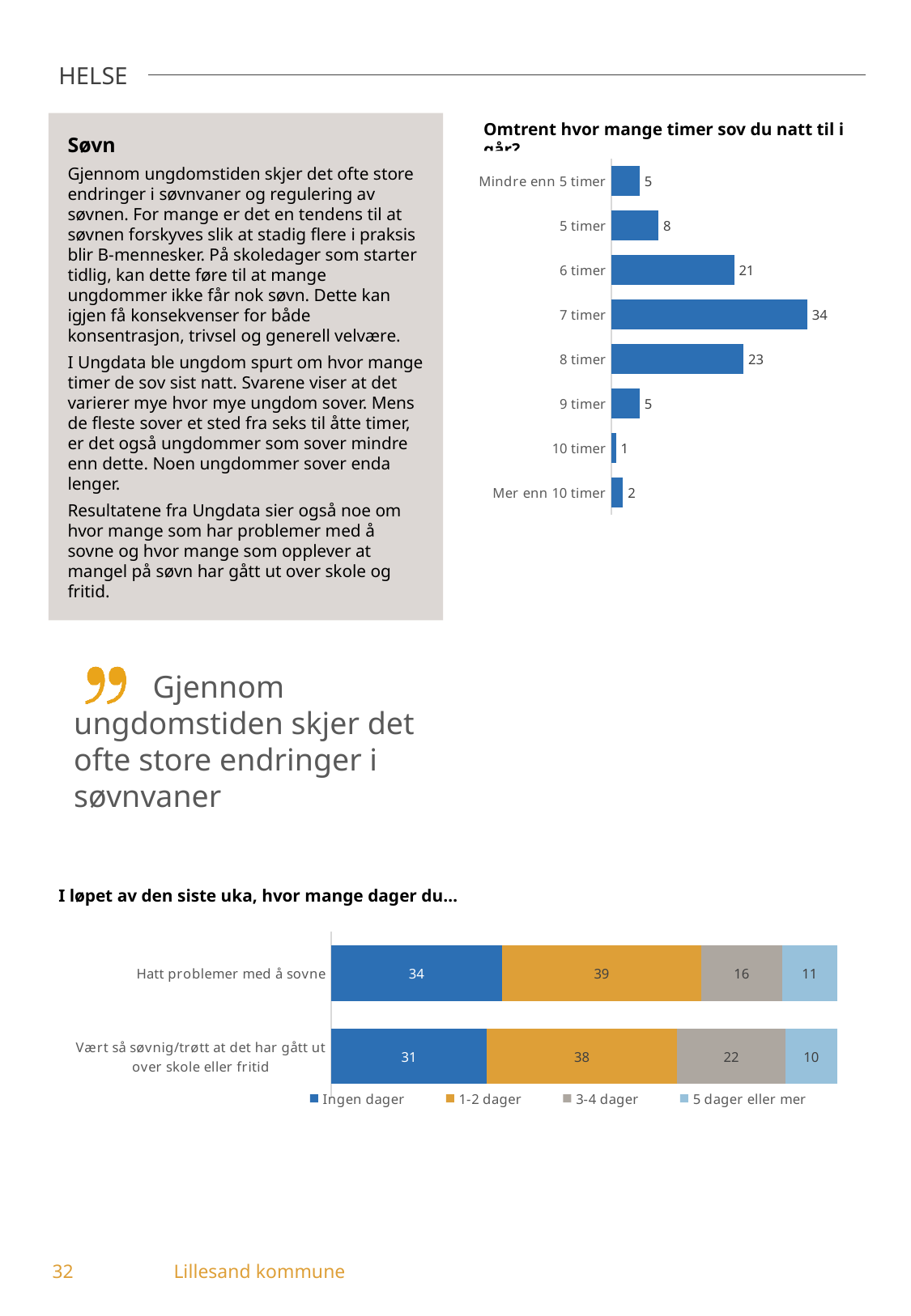
In the chart 'Omtrent hvor mange timer sov du natt til i går?', which category has the lowest value? 10 timer In the chart 'Omtrent hvor mange timer sov du natt til i går?', what is the value for '7 timer'? 34 In the chart 'I løpet av den siste uka, hvor mange dager du…', which is larger: the '3-4 dager' value for 'Hatt problemer med å sovne' or for 'Vært så søvnig/trøtt at det har gått ut over skole eller fritid'? Vært så søvnig/trøtt at det har gått ut over skole eller fritid In the chart 'Omtrent hvor mange timer sov du natt til i går?', which category has the highest value? 7 timer In the chart 'I løpet av den siste uka, hvor mange dager du…', which legend entry is shown in orange? 1-2 dager In the chart 'Omtrent hvor mange timer sov du natt til i går?', what is the value for 'Mer enn 10 timer'? 2 In the chart 'I løpet av den siste uka, hvor mange dager du…', how many series does the legend list? 4 In the chart 'Omtrent hvor mange timer sov du natt til i går?', how many categories are shown? 8 What kind of chart is 'Omtrent hvor mange timer sov du natt til i går?'? Bar chart In the chart 'I løpet av den siste uka, hvor mange dager du…', what is the total of the stacked bar for 'Vært så søvnig/trøtt at det har gått ut over skole eller fritid'? 101 In the chart 'I løpet av den siste uka, hvor mange dager du…', what is the value for 'Ingen dager' in 'Hatt problemer med å sovne'? 34 In the chart 'Omtrent hvor mange timer sov du natt til i går?', what is the difference between the values for '8 timer' and '6 timer'? 2